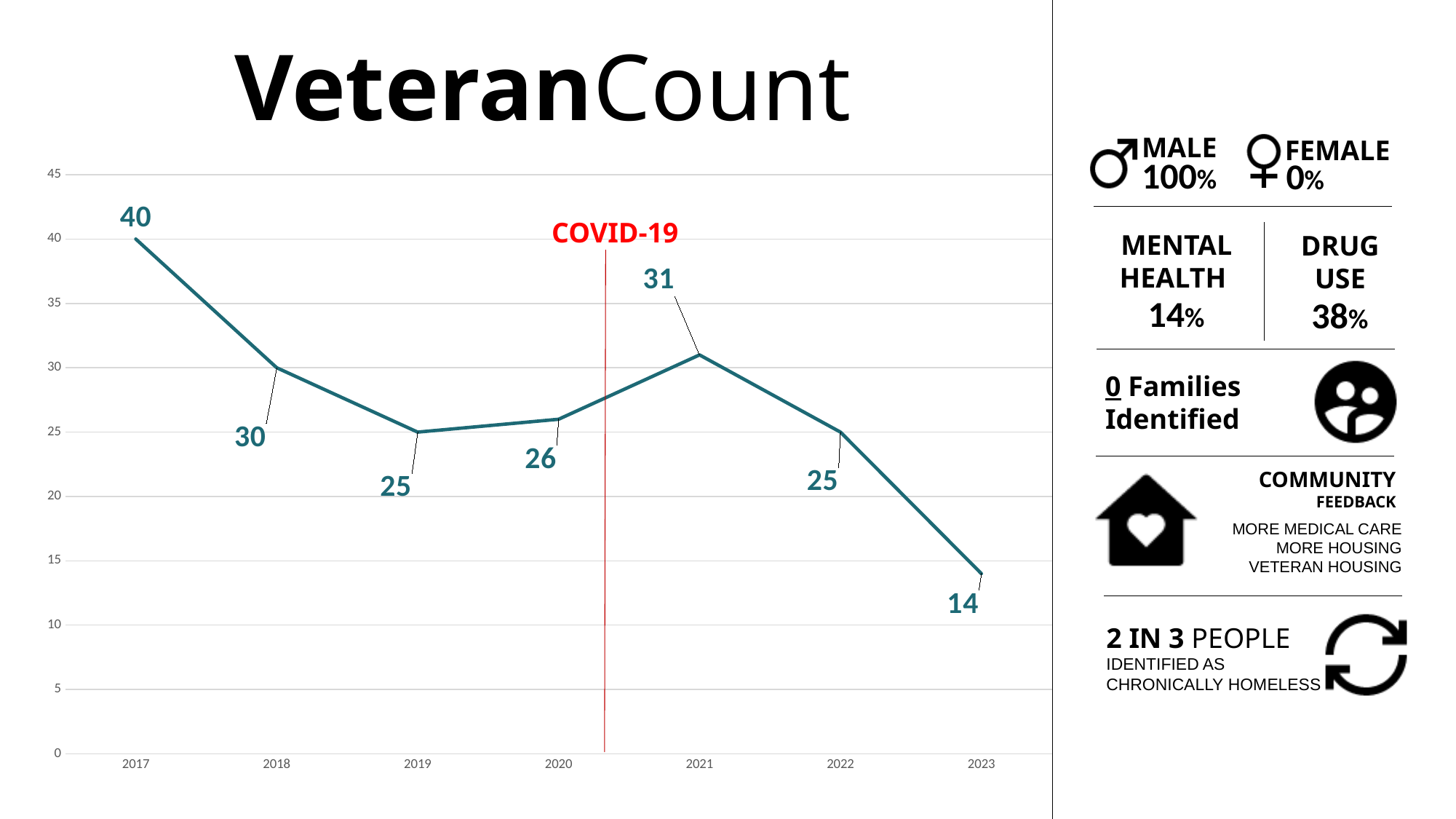
Which year has the lowest veteran count? 2023 What is the difference between the veteran count in 2017 and in 2023? 26 Is the veteran count for 2018 greater or less than 25? greater What is the veteran count for 2023? 14 What is the veteran count for 2017? 40 Does the veteran count rise or fall from 2021 to 2023? fall What label is shown on the red vertical line in the chart? COVID-19 Which year has a higher veteran count, 2020 or 2021? 2021 Which year has the highest veteran count? 2017 What kind of chart is shown on the slide? line chart How many years are plotted on the chart? 7 What is the veteran count for 2021? 31